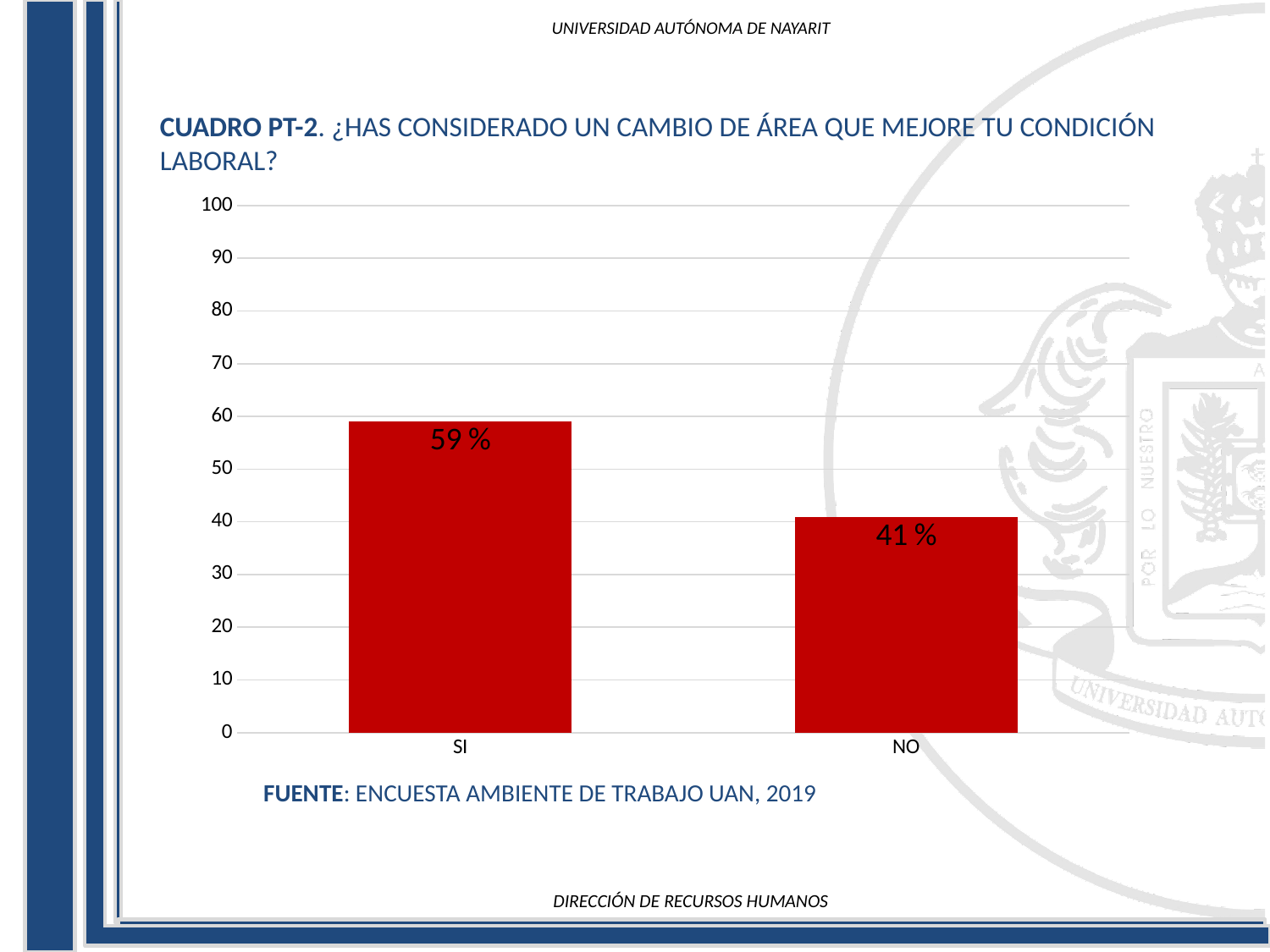
Which category has the lowest value? NO What is the difference between the values for SI and NO? 18 % Which category has the highest value? SI How many categories are shown on the x axis? 2 What is the total of the values for SI and NO? 100 % Is the value for NO greater or less than 50? less Is the value for SI greater or less than 50? greater What is the value for SI? 59 % What is the value for NO? 41 % Which is larger, the value for SI or the value for NO? SI What is the source cited below the chart? ENCUESTA AMBIENTE DE TRABAJO UAN, 2019 What kind of chart is shown on the slide? bar chart